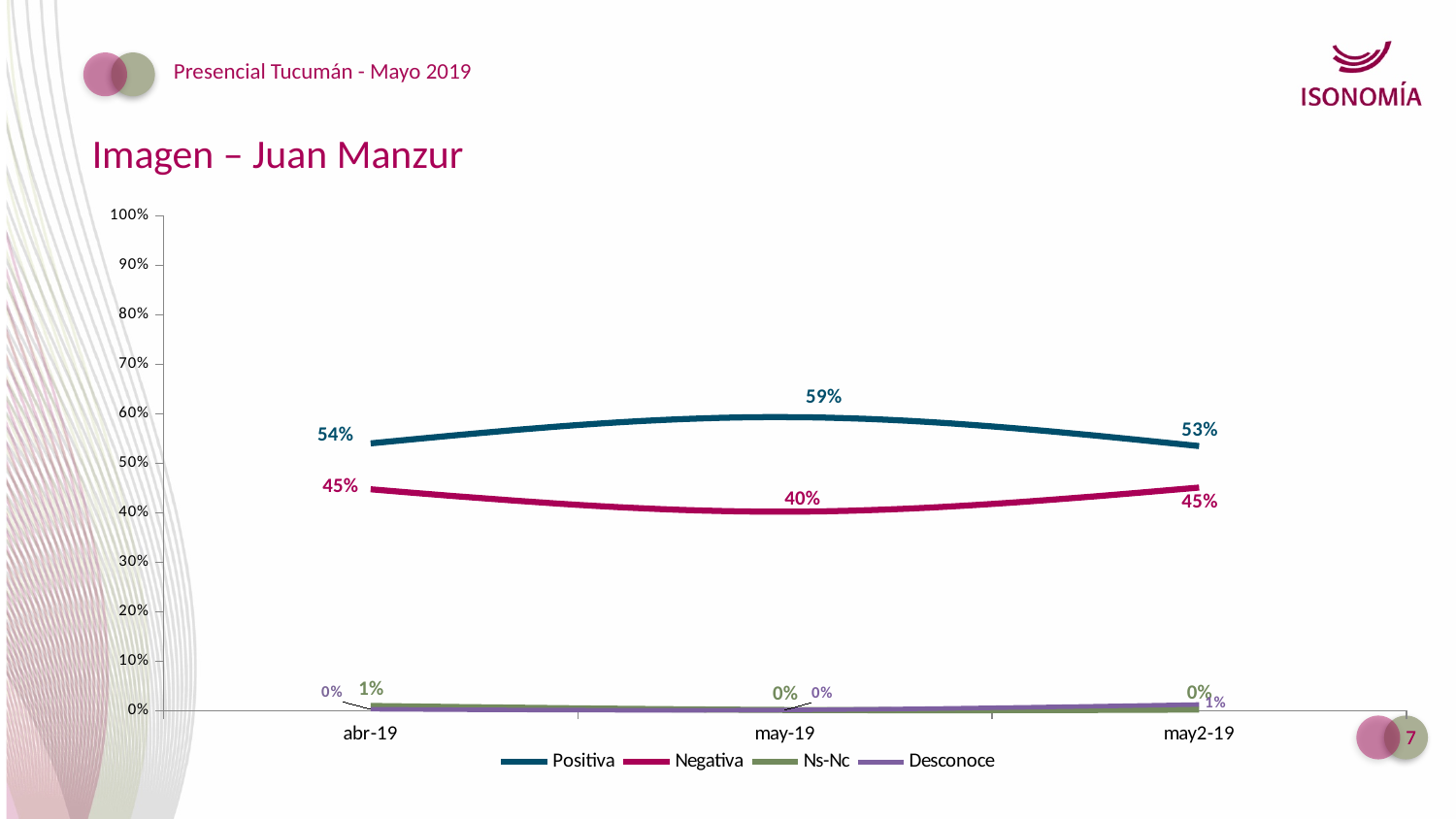
How many dates are shown on the x axis? 3 What is the value for Positiva at may2-19? 53% What is the value for Negativa at may-19? 40% Is the value for Positiva at abr-19 greater or less than 50%? greater What is the difference between Positiva and Negativa at may-19? 19% How many series does the legend list? 4 Which is larger at abr-19, Positiva or Negativa? Positiva What kind of chart is shown on the slide? line chart At which date is the Negativa series lowest? may-19 At which date is the Positiva series highest? may-19 What is the value for Positiva at may-19? 59% What is the value for Negativa at abr-19? 45%